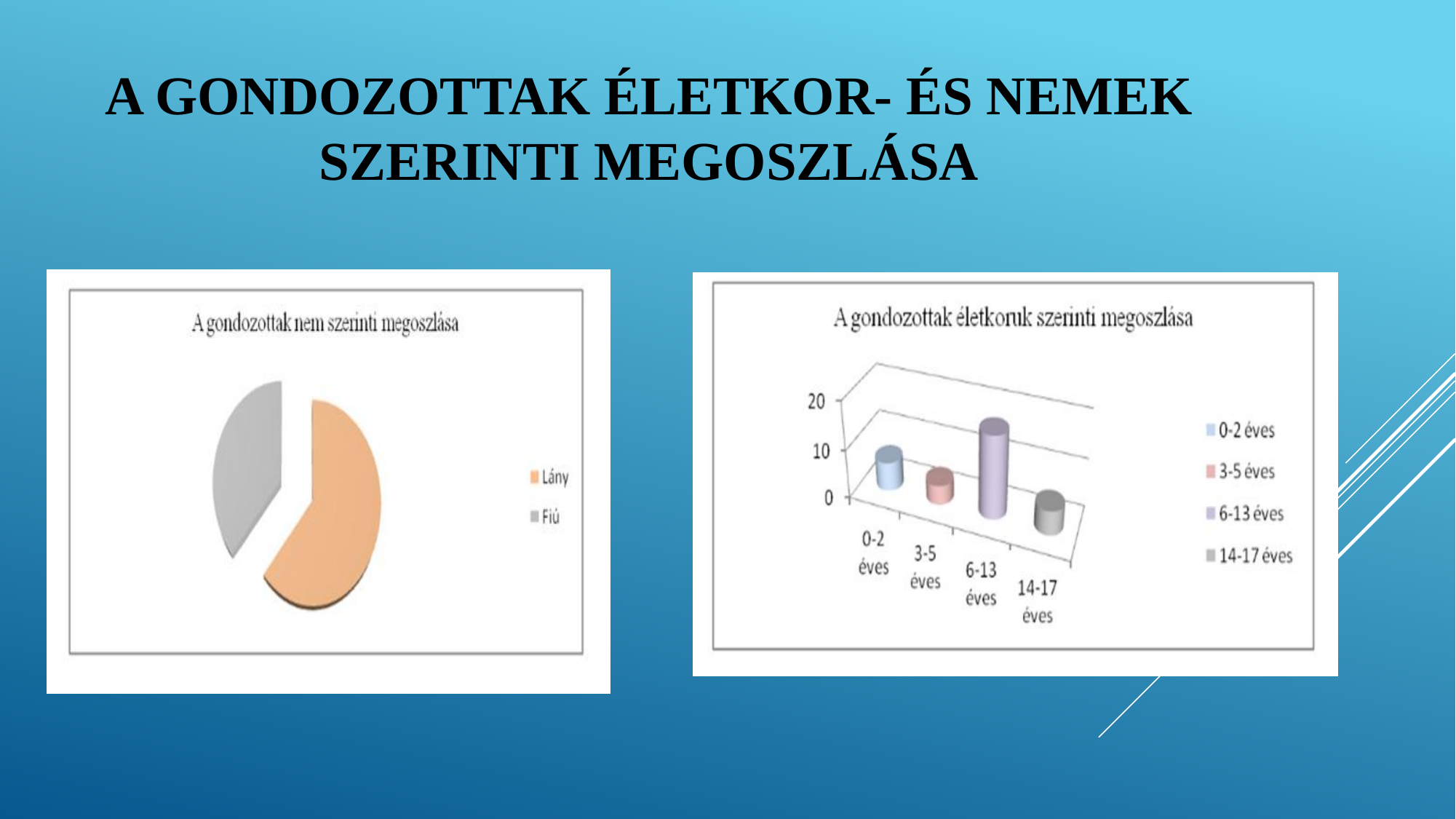
In the right chart, how many age categories are shown on the x axis? 4 In the right chart, which is larger, the value for 6-13 éves or the value for 14-17 éves? 6-13 éves In the right chart, which age group has the highest value? 6-13 éves What type of chart is the right chart titled 'A gondozottak életkoruk szerinti megoszlása'? bar chart In the right chart, how many entries does the legend list? 4 What type of chart is the left chart titled 'A gondozottak nem szerinti megoszlása'? pie chart In the right chart, is the value for 0-2 éves greater or less than 10? less In the left pie chart, how many slices are shown? 2 In the right chart, is the value for 6-13 éves greater or less than 10? greater In the right chart, which is larger, the value for 0-2 éves or the value for 3-5 éves? 0-2 éves In the left pie chart, which slice is larger, Lány or Fiú? Lány In the left pie chart, which category is shown in grey? Fiú